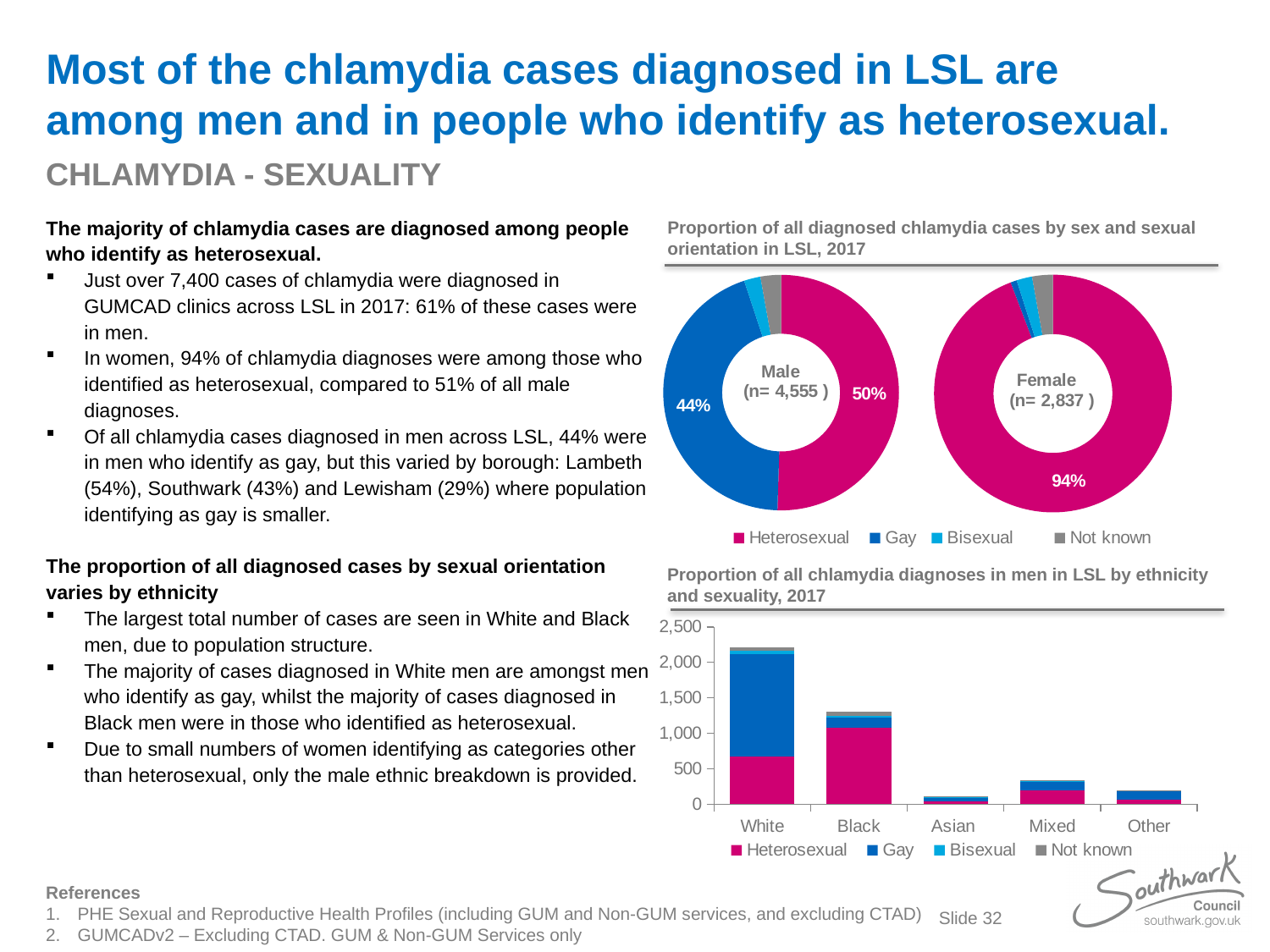
In the chart 'Proportion of all chlamydia diagnoses in men in LSL by ethnicity and sexuality, 2017', which ethnicity has the highest total bar? White In the donut chart 'Proportion of all diagnosed chlamydia cases by sex and sexual orientation in LSL, 2017', what percentage of female cases are Heterosexual? 94% In the donut chart 'Proportion of all diagnosed chlamydia cases by sex and sexual orientation in LSL, 2017', what percentage of male cases are Gay? 44% What kind of chart is 'Proportion of all chlamydia diagnoses in men in LSL by ethnicity and sexuality, 2017'? Stacked bar chart In the chart 'Proportion of all chlamydia diagnoses in men in LSL by ethnicity and sexuality, 2017', is the total for Black greater or less than 1,500? less In the chart 'Proportion of all chlamydia diagnoses in men in LSL by ethnicity and sexuality, 2017', is the total for White greater or less than 2,000? greater In the chart 'Proportion of all chlamydia diagnoses in men in LSL by ethnicity and sexuality, 2017', is the total for Mixed greater or less than 500? less In the donut chart 'Proportion of all diagnosed chlamydia cases by sex and sexual orientation in LSL, 2017', how many categories does the legend list? 4 In the chart 'Proportion of all chlamydia diagnoses in men in LSL by ethnicity and sexuality, 2017', how many ethnicity categories are shown on the x axis? 5 In the donut chart 'Proportion of all diagnosed chlamydia cases by sex and sexual orientation in LSL, 2017', what is the n value shown for Male? 4,555 In the donut chart 'Proportion of all diagnosed chlamydia cases by sex and sexual orientation in LSL, 2017', what percentage of male cases are Heterosexual? 50% In the donut chart 'Proportion of all diagnosed chlamydia cases by sex and sexual orientation in LSL, 2017', which is larger: the Heterosexual share for Male or for Female? Female